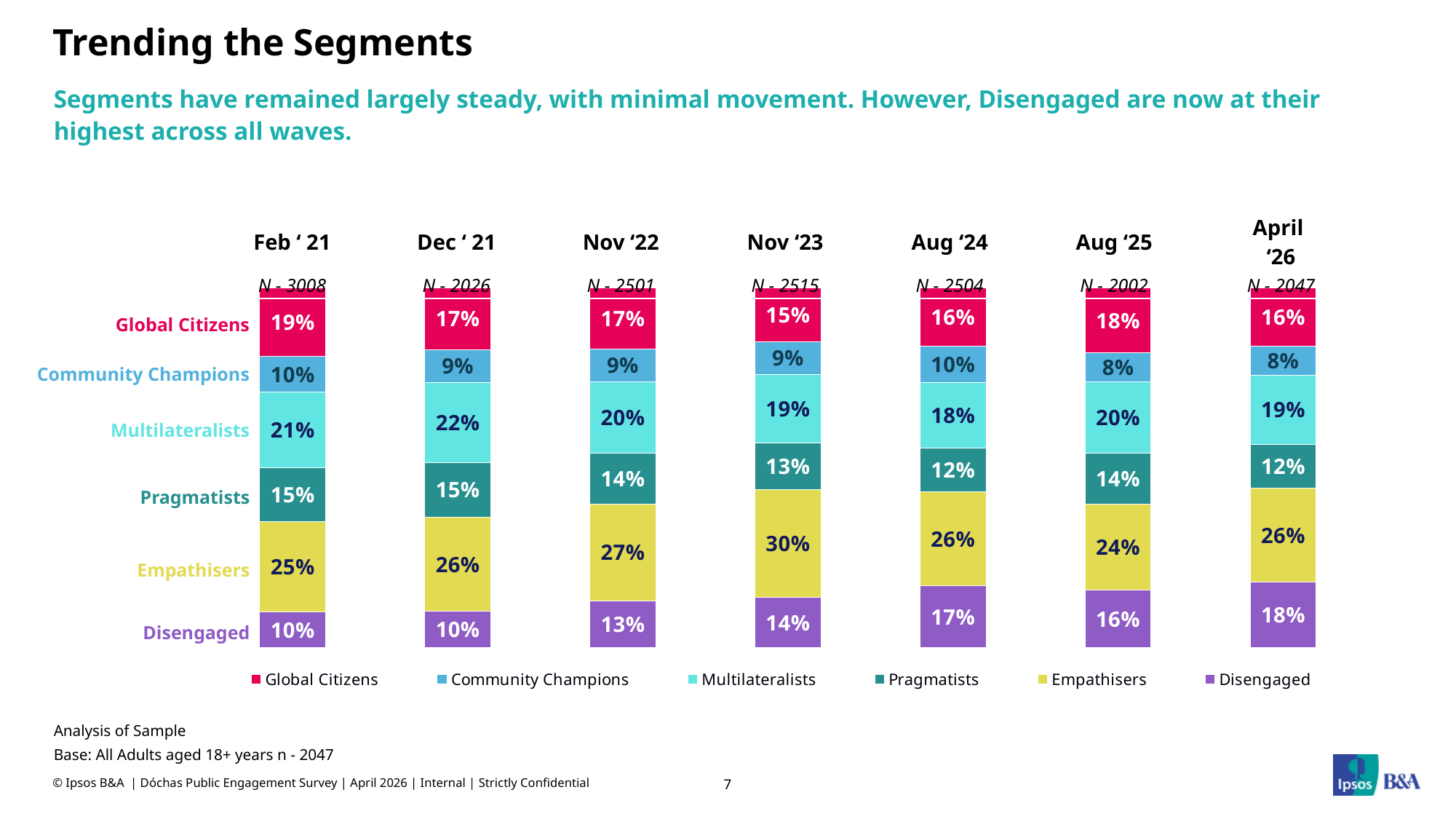
Which wave has the larger Empathisers value, Nov '23 or Aug '25? Nov '23 How many segments does the legend list? 6 In which wave is the Global Citizens segment lowest? Nov '23 What is the value for Disengaged in April '26? 18% In which wave is the Disengaged segment highest? April '26 By how many percentage points did Disengaged change from Feb '21 to April '26? 8 percentage points What is the value for Empathisers in Nov '23? 30% How many survey waves are shown in the chart? 7 What is the value for Community Champions in Aug '25? 8% Does the Disengaged segment generally rise or fall from Feb '21 to April '26? Rise What kind of chart is shown on the slide? Stacked bar chart What is the sample size (N) shown for the Nov '22 wave? N - 2501